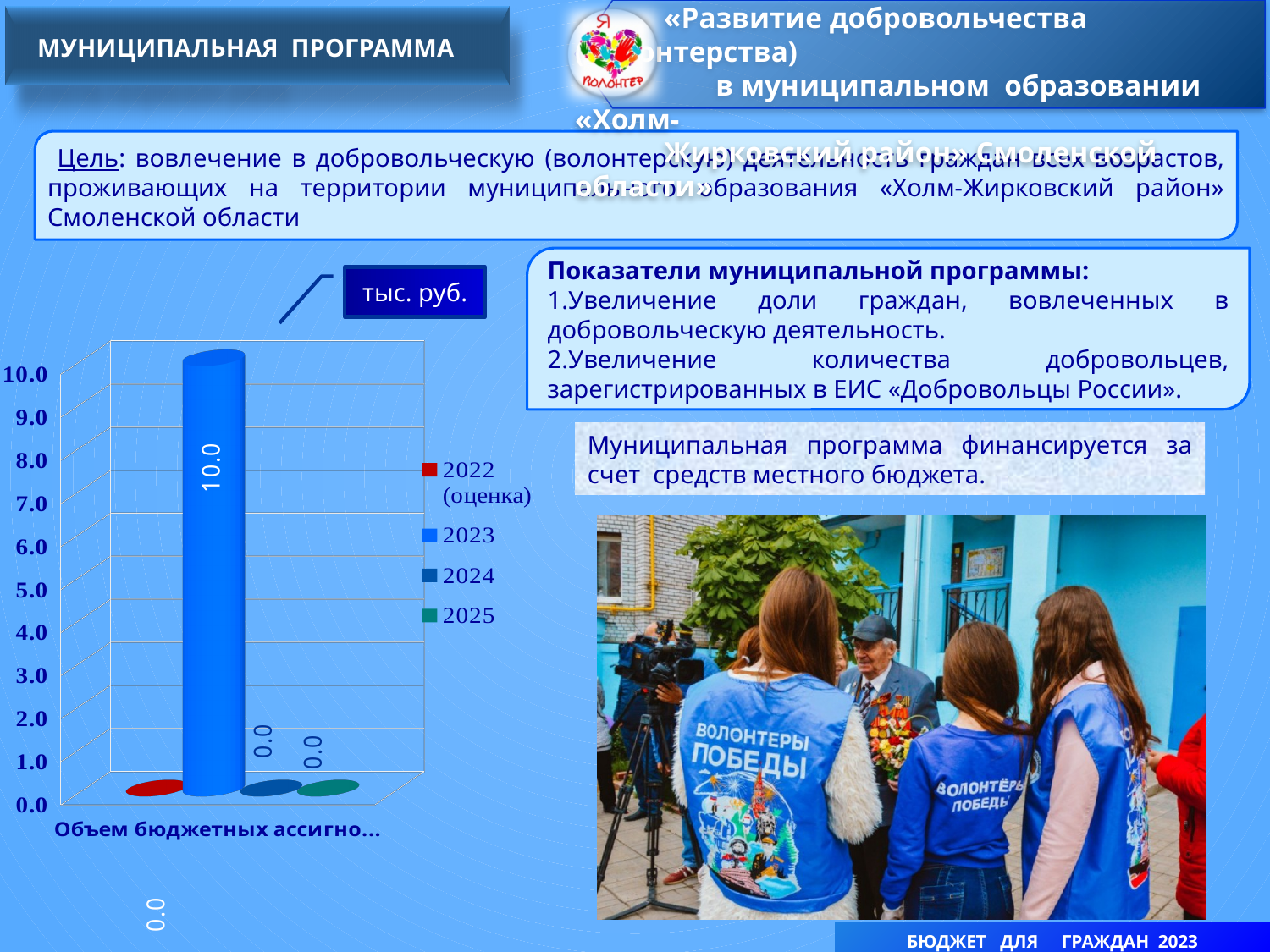
What is the value for 2025 in the chart? 0.0 Which year has the highest value in the chart? 2023 What is the first legend entry of the chart? 2022 (оценка) What is the highest value shown on the chart's vertical axis? 10.0 What is the difference between the values for 2023 and 2024? 10.0 What kind of chart is shown on the slide? bar chart What is the value for 2023 in the chart? 10.0 How many series does the chart legend list? 4 What unit of measurement is indicated for the chart? тыс. руб. What is the value for 2024 in the chart? 0.0 Which is larger, the value for 2023 or the value for 2025? 2023 Is the value for 2023 greater or less than 5.0? greater